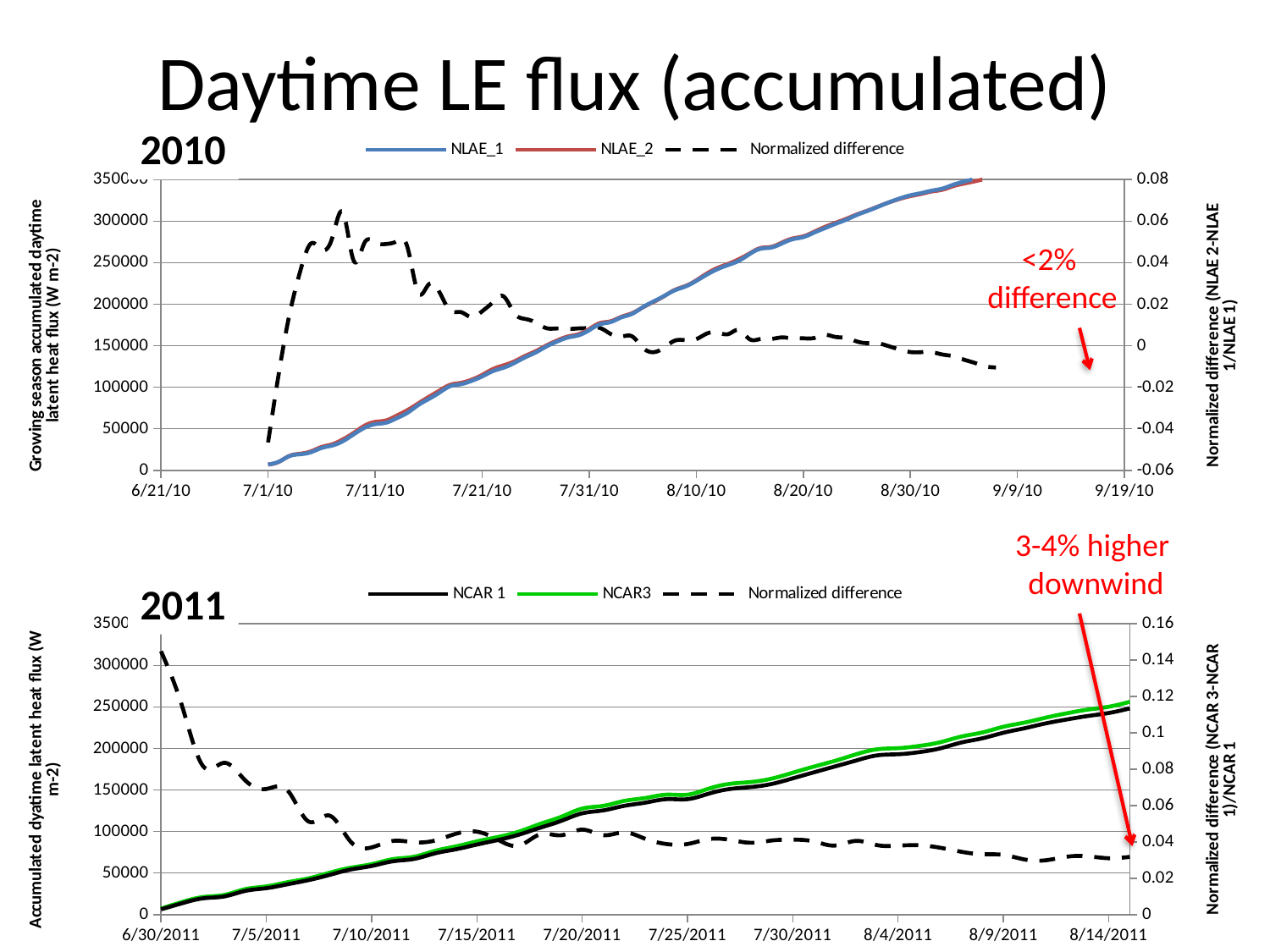
In the bottom (2011) chart, does the Normalized difference series rise or fall overall along the x axis? falls What kind of chart is the top (2010) chart? line chart In the bottom (2011) chart, is the Normalized difference value at 6/30/2011 greater or less than 0.12? greater How many series does the legend of the top (2010) chart list? 3 In the bottom (2011) chart, is the NCAR 1 value at 7/30/2011 greater or less than 200000? less What is the maximum value shown on the right-hand axis of the top (2010) chart? 0.08 In the bottom (2011) chart, what colour is the NCAR3 line? green In the top (2010) chart, does the NLAE_1 series rise or fall along the x axis? rises In the top (2010) chart, is the NLAE_1 value at 8/10/10 greater or less than 150000? greater In the bottom (2011) chart, which series is higher at 8/14/2011, NCAR 1 or NCAR3? NCAR3 How many series does the legend of the bottom (2011) chart list? 3